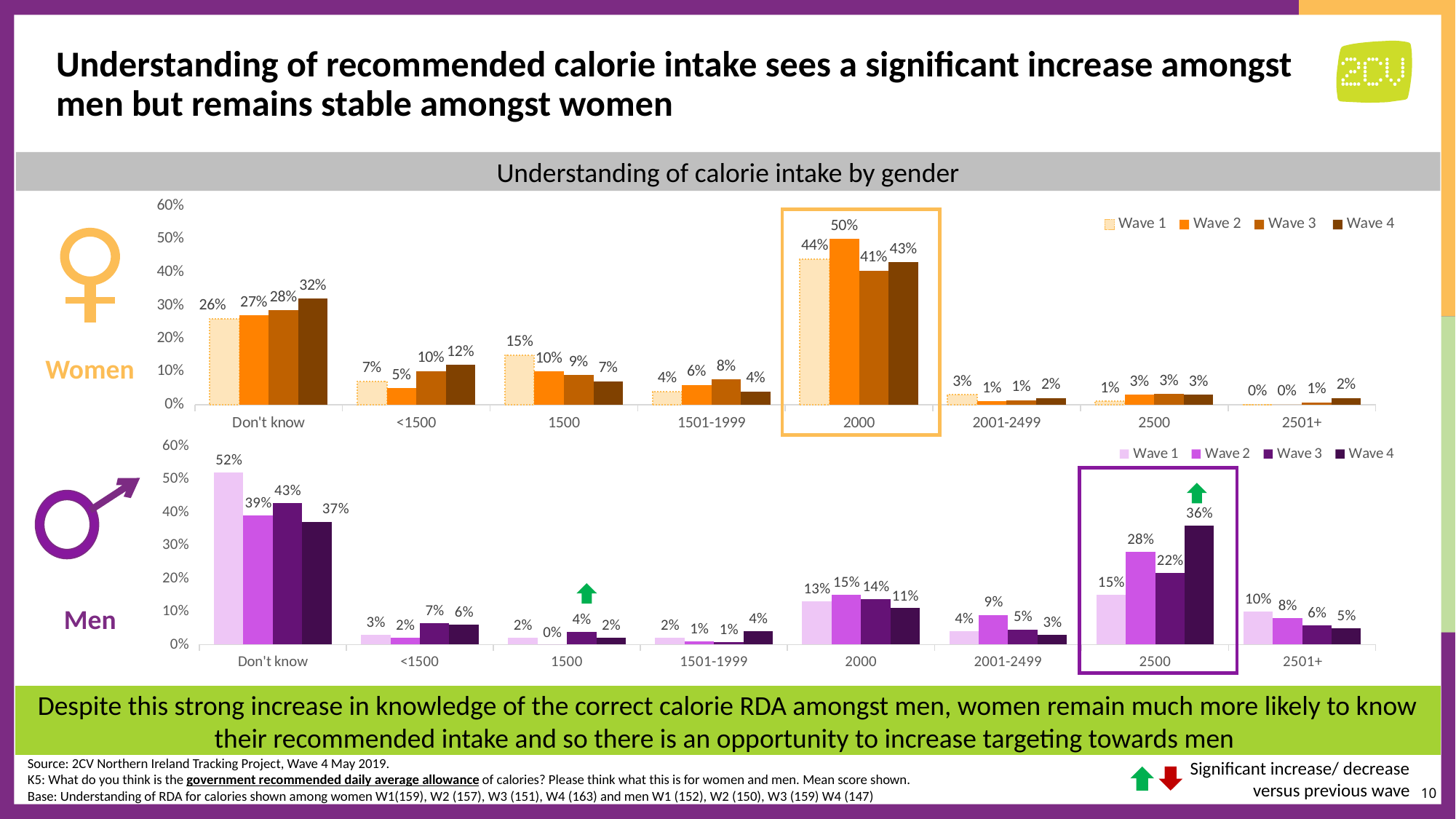
In the Men chart, what is the Wave 4 value for the 2500 category? 36% In the Men chart, which is larger for the Don't know category: Wave 2 or Wave 3? Wave 3 In the Women chart, what is the difference between the Wave 4 and Wave 1 values for the Don't know category? 6% In the Men chart, which category has the highest Wave 1 value? Don't know What kind of chart is the Women chart? Bar chart In the Men chart, what is the difference between the Wave 4 and Wave 1 values for the 2500 category? 21% How many series does the legend of the Women chart list? 4 In the Women chart, what is the Wave 1 value for the 1500 category? 15% In the Women chart, do the Wave values for the Don't know category rise or fall from Wave 1 to Wave 4? Rise In the Women chart, what is the Wave 2 value for the 2000 category? 50% How many categories are shown on the x axis of the Men chart? 8 In the Women chart, which category has the highest Wave 4 value? 2000